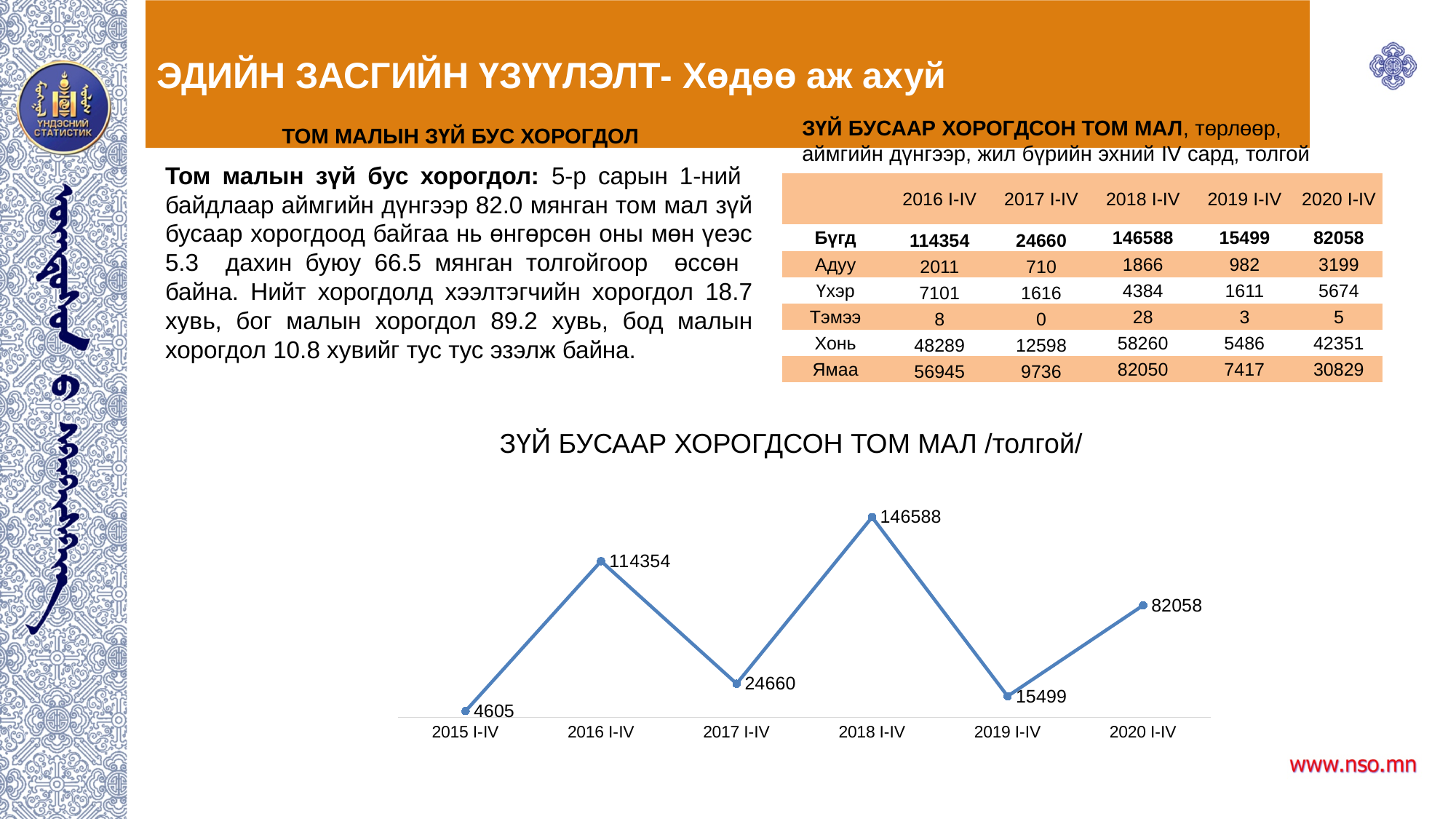
What type of chart is shown on the slide? line chart Which is larger in the line chart, the value for 2016 I-IV or the value for 2020 I-IV? 2016 I-IV What is the difference between the values for 2018 I-IV and 2019 I-IV in the line chart? 131089 What is the value for 2018 I-IV in the line chart? 146588 What is the value for 2020 I-IV in the line chart? 82058 What is the value for 2017 I-IV in the line chart? 24660 What is the value for 2015 I-IV in the line chart? 4605 How many data points are plotted in the line chart? 6 Which period has the lowest value in the line chart? 2015 I-IV What is the title of the line chart? ЗҮЙ БУСААР ХОРОГДСОН ТОМ МАЛ /толгой/ Which period has the highest value in the line chart? 2018 I-IV What is the difference between the values for 2016 I-IV and 2017 I-IV in the line chart? 89694